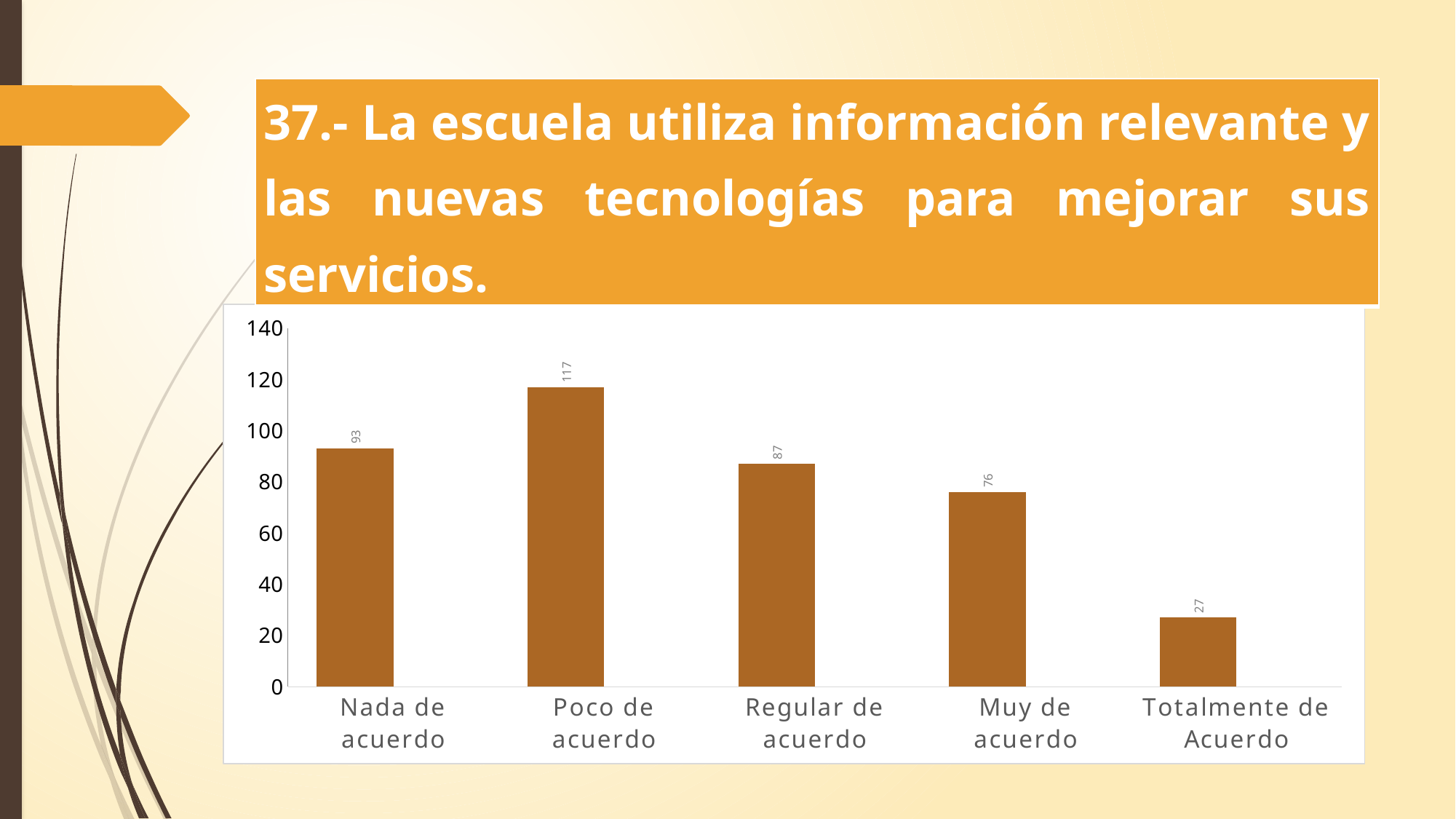
What is the value for "Totalmente de Acuerdo"? 27 Which category has the lowest value? Totalmente de Acuerdo How many categories are shown on the x axis? 5 What is the difference between the values for "Poco de acuerdo" and "Nada de acuerdo"? 24 Is the value for "Muy de acuerdo" greater or less than 80? less Which category has the highest value? Poco de acuerdo What is the value for "Poco de acuerdo"? 117 What is the highest value shown on the vertical axis? 140 What is the difference between the values for "Muy de acuerdo" and "Totalmente de Acuerdo"? 49 Which is larger, the value for "Nada de acuerdo" or the value for "Regular de acuerdo"? Nada de acuerdo What is the value for "Regular de acuerdo"? 87 What kind of chart is shown on the slide? bar chart